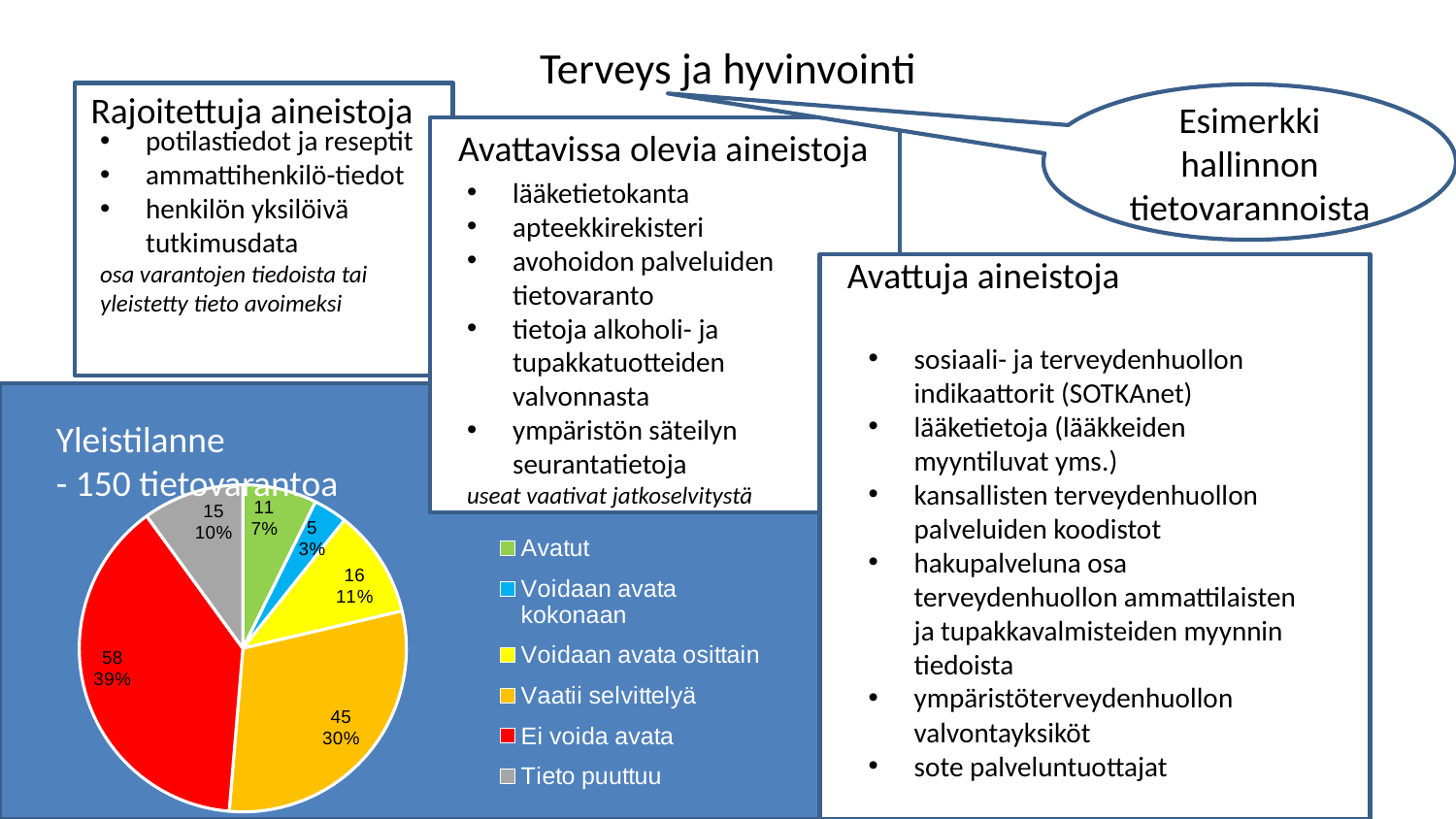
What is the value for 'Ei voida avata' in the pie chart? 58 What kind of chart is shown on the slide? pie chart How many entries does the legend of the pie chart list? 6 How many slices does the pie chart have? 6 What is the value for 'Voidaan avata osittain' in the pie chart? 16 What percentage share does 'Vaatii selvittelyä' have in the pie chart? 30% Which category has the largest slice in the pie chart? Ei voida avata What percentage share does 'Avatut' have in the pie chart? 7% Which is larger in the pie chart, 'Tieto puuttuu' or 'Voidaan avata osittain'? Voidaan avata osittain Which category has the smallest slice in the pie chart? Voidaan avata kokonaan What colour is the 'Ei voida avata' slice in the pie chart? red What is the difference between the values for 'Ei voida avata' and 'Vaatii selvittelyä' in the pie chart? 13